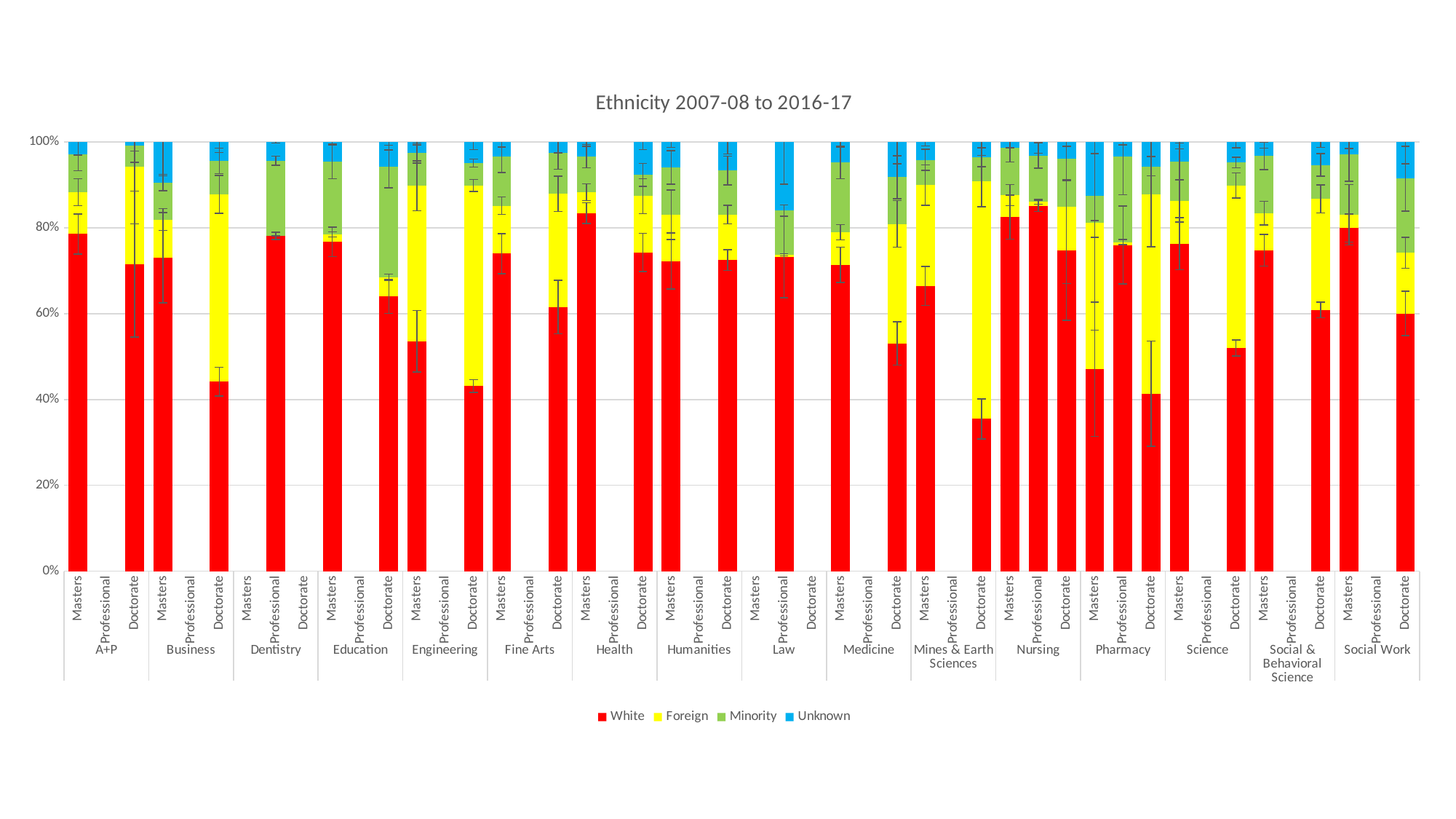
Is the White share for the Mines & Earth Sciences Doctorate bar greater or less than 40%? less How many colleges (category groups) are shown along the x axis? 16 What value does each full stacked bar reach on the y axis? 100% Is the White share for the Pharmacy Masters bar greater or less than 60%? less What is the title of the chart? Ethnicity 2007-08 to 2016-17 Is the White share for the Health Masters bar greater or less than 80%? greater What kind of chart is shown on the slide? Stacked bar chart Which series is shown in red at the bottom of each stacked bar? White Which bar has the smallest White share: Health Masters or Mines & Earth Sciences Doctorate? Mines & Earth Sciences Doctorate How many colleges have a Professional bar plotted? 4 How many series does the legend list? 4